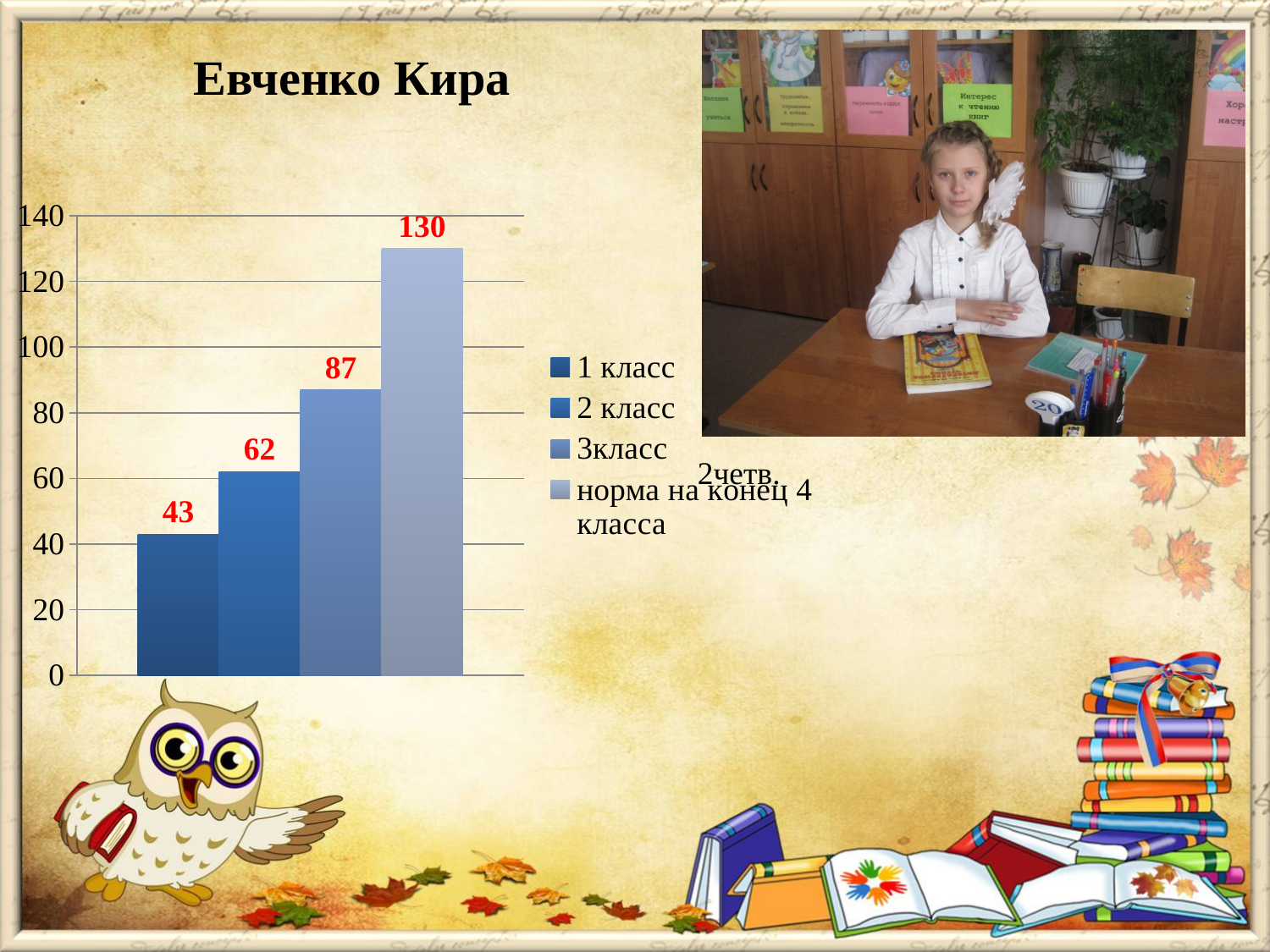
What is the value for 1 класс? 43 Which legend entry has the lowest value? 1 класс What is the difference between норма на конец 4 класса and 3класс? 43 What is the difference between the values for 3класс and 2 класс? 25 What is the value for 3класс? 87 What is the value for норма на конец 4 класса? 130 What is the value for 2 класс? 62 Which legend entry has the highest value? норма на конец 4 класса How many bars are plotted in the chart? 4 Which is larger, the value for 2 класс or the value for 1 класс? 2 класс How many entries does the legend list? 4 What kind of chart is shown on the slide? bar chart